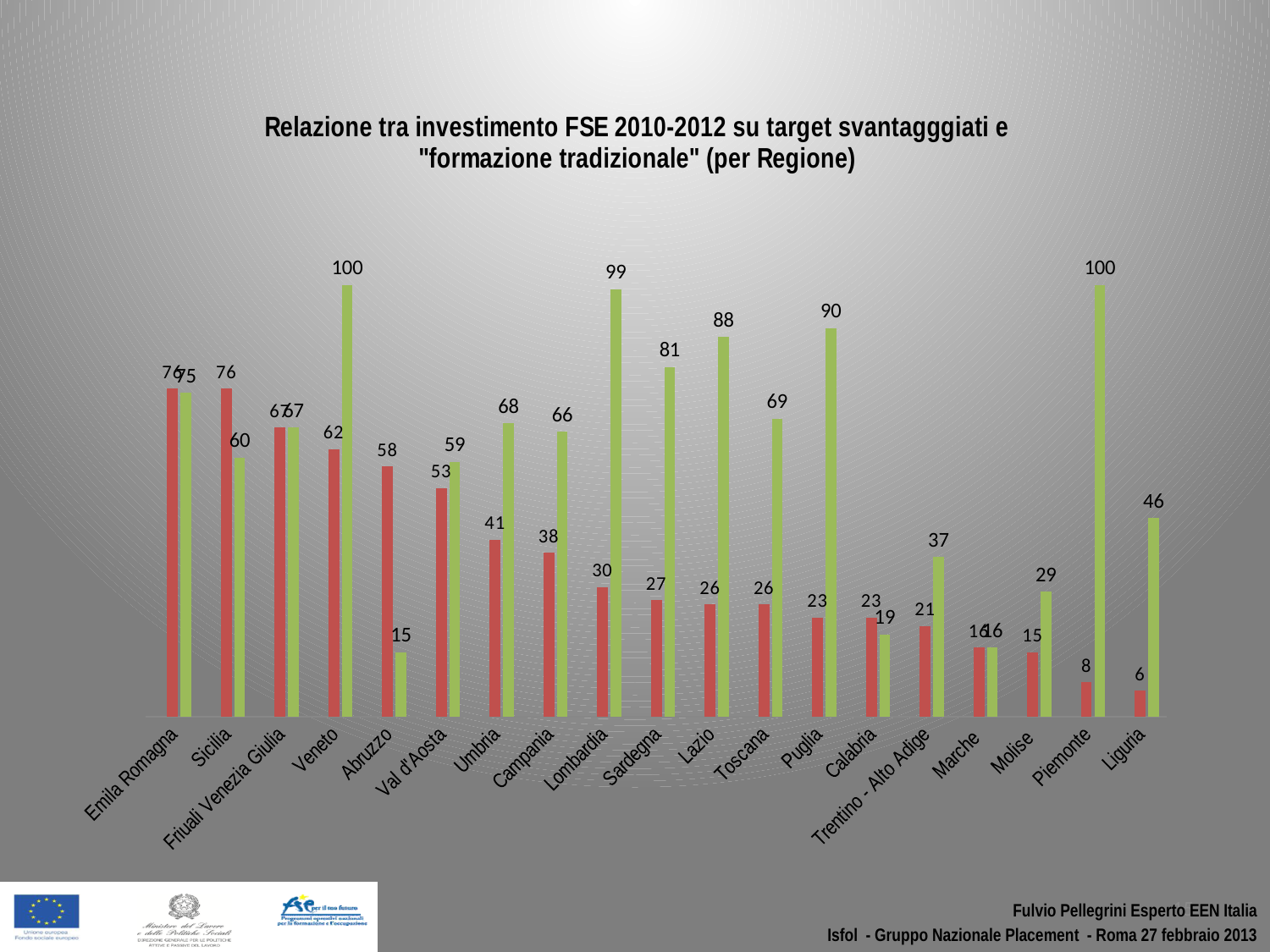
For Sicilia, which bar is larger, the red one or the green one? the red one What kind of chart is shown on the slide? bar chart What is the value of the green bar for Liguria? 46 Do the red bars rise or fall from left to right across the regions? fall How many regions are shown along the x axis of the chart? 19 Which region has the lowest green bar? Abruzzo What is the title of the chart? Relazione tra investimento FSE 2010-2012 su target svantagggiati e "formazione tradizionale" (per Regione) What is the value of the green bar for Molise? 29 What is the value of the red bar for Abruzzo? 58 For Veneto, what is the difference between the green bar and the red bar? 38 Which region has the lowest red bar? Liguria What is the value of the green bar for Lombardia? 99